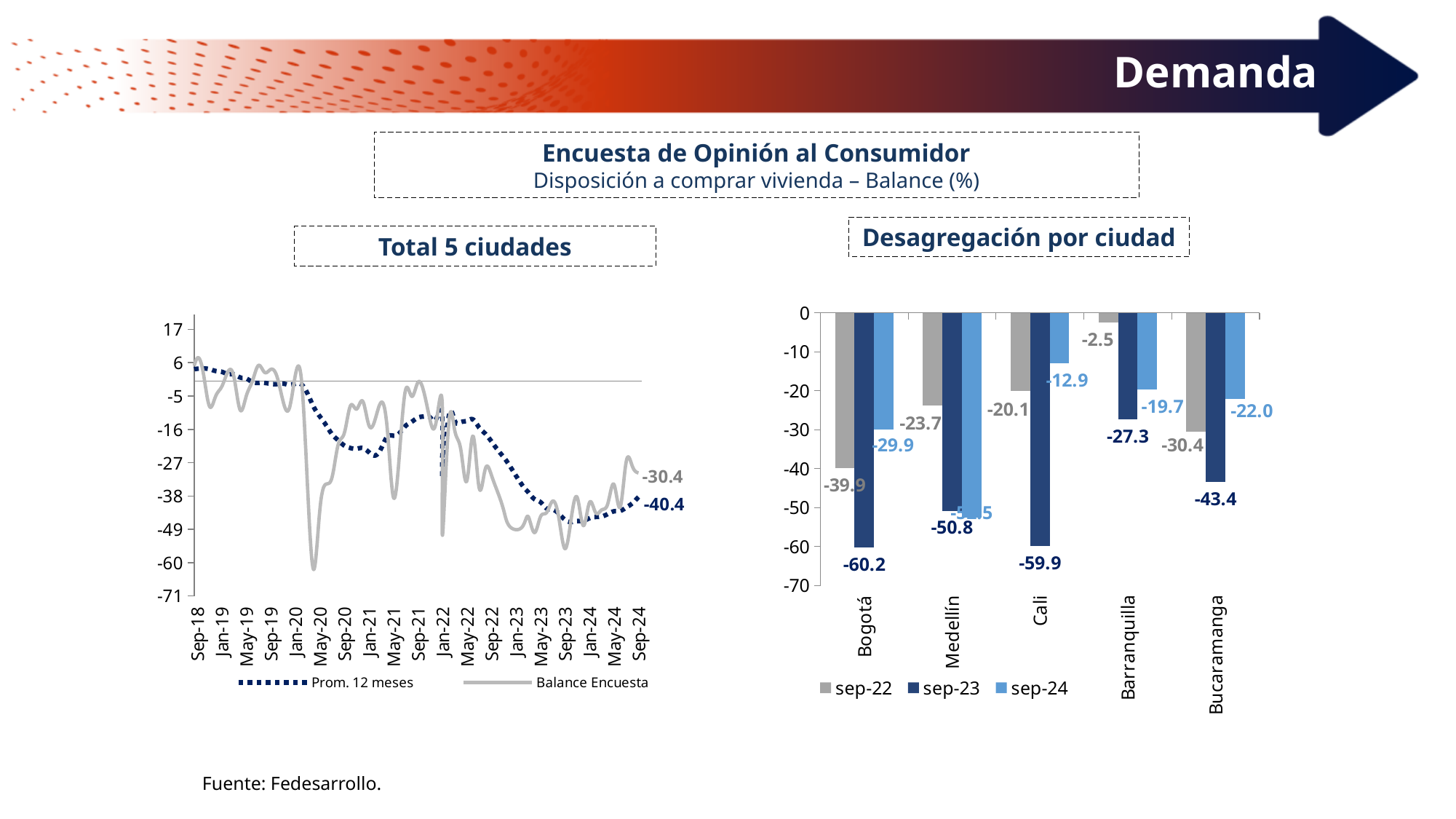
What kind of chart is the 'Total 5 ciudades' chart? Line chart In the 'Total 5 ciudades' chart, what is the latest value labelled for the 'Balance Encuesta' series? -30.4 In the 'Desagregación por ciudad' chart, what is the sep-22 value for Barranquilla? -2.5 In the 'Total 5 ciudades' chart, what is the latest value labelled for the 'Prom. 12 meses' series? -40.4 In the 'Desagregación por ciudad' chart, what is the sep-24 value for Cali? -12.9 How many series does the legend of the 'Desagregación por ciudad' chart list? 3 In the 'Desagregación por ciudad' chart, which city has the highest sep-22 value? Barranquilla In the 'Desagregación por ciudad' chart, which is larger, the sep-24 value for Bogotá or the sep-24 value for Bucaramanga? Bucaramanga In the 'Desagregación por ciudad' chart, which city has the lowest sep-23 value? Bogotá How many cities are shown on the x axis of the 'Desagregación por ciudad' chart? 5 In the 'Desagregación por ciudad' chart, what is the sep-23 value for Bogotá? -60.2 In the 'Desagregación por ciudad' chart, what is the difference between the sep-23 and sep-24 values for Bucaramanga? 21.4